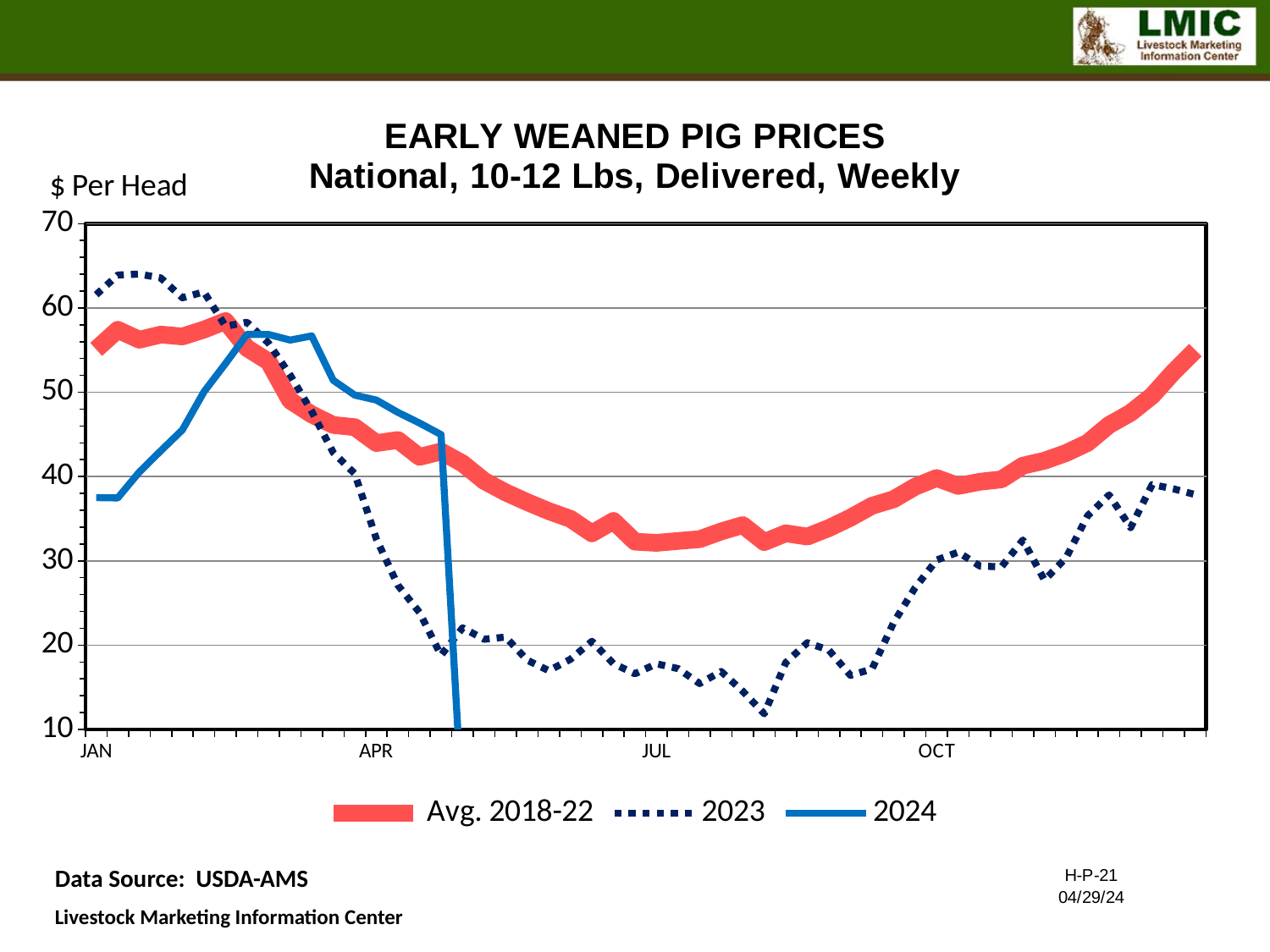
What unit is shown on the y axis of the chart? $ Per Head Is the value for the Avg. 2018-22 series in July greater or less than 40? less Is the value for the 2024 series in January greater or less than 40? less In July, which is larger: the Avg. 2018-22 series or the 2023 series? Avg. 2018-22 Which series has the highest value in January? 2023 Does the Avg. 2018-22 series rise or fall from October to the end of the year? Rise How many series does the legend list? 3 What is the title of the chart? EARLY WEANED PIG PRICES National, 10-12 Lbs, Delivered, Weekly Is the value for the 2023 series in January greater or less than 60? greater Does the Avg. 2018-22 series rise or fall from January to July? Fall What kind of chart is shown on the slide? Line chart